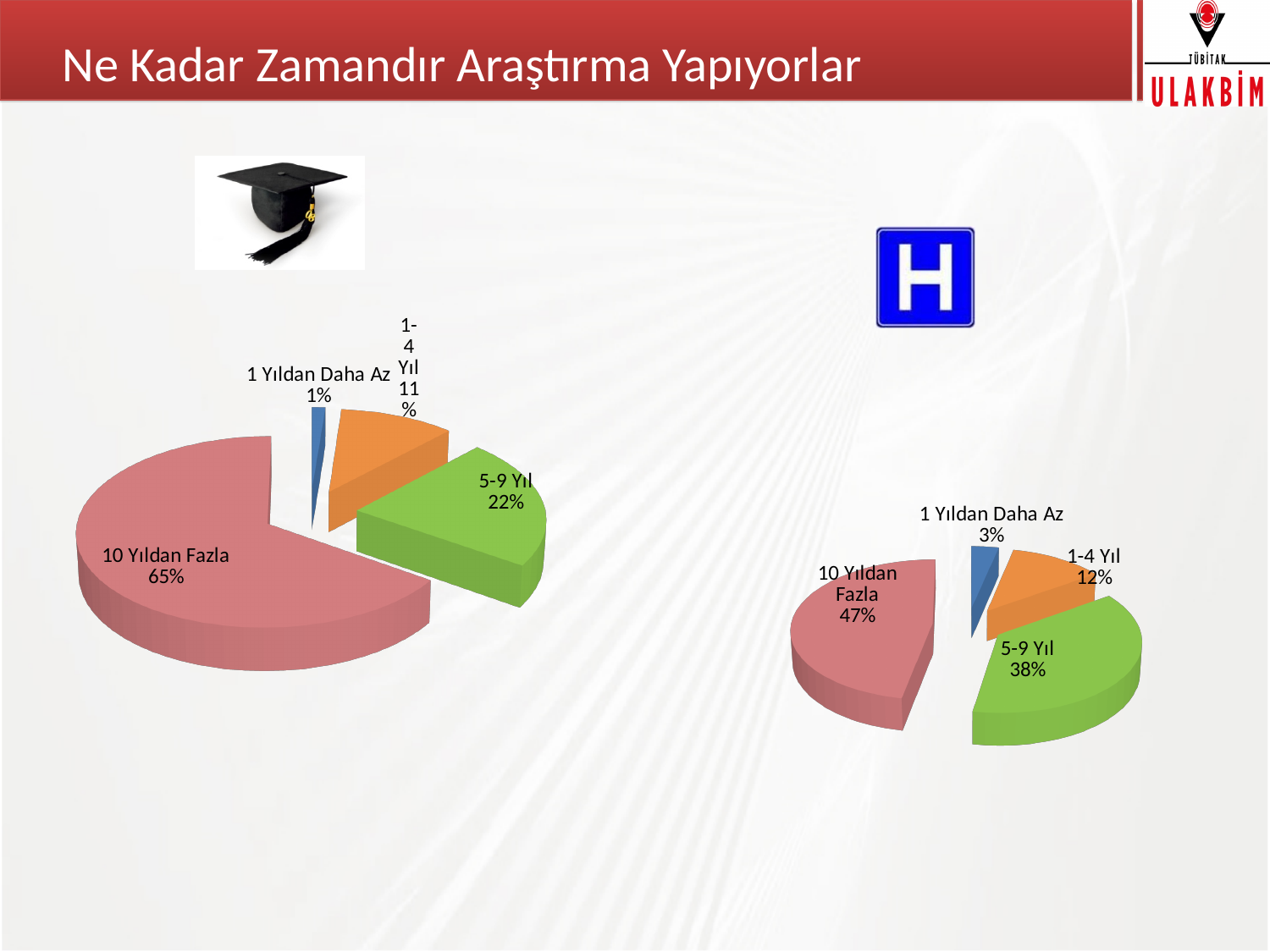
In the left pie chart, what is the difference between the shares for 5-9 Yıl and 1-4 Yıl? 11% In the left pie chart, what is the share for 5-9 Yıl? 22% What type of chart is the left chart on the slide? pie chart In the right pie chart, what is the share for 5-9 Yıl? 38% In the left pie chart, which category has the largest share? 10 Yıldan Fazla How many slices does the right pie chart have? 4 In the right pie chart, what is the share for 1 Yıldan Daha Az? 3% In the left pie chart, what is the share for 10 Yıldan Fazla? 65% In the right pie chart, what is the difference between the shares for 10 Yıldan Fazla and 5-9 Yıl? 9% Which chart shows a larger share for 10 Yıldan Fazla, the left pie chart or the right pie chart? the left pie chart In the right pie chart, which category has the smallest share? 1 Yıldan Daha Az In the left pie chart, what colour is the 10 Yıldan Fazla slice? pink